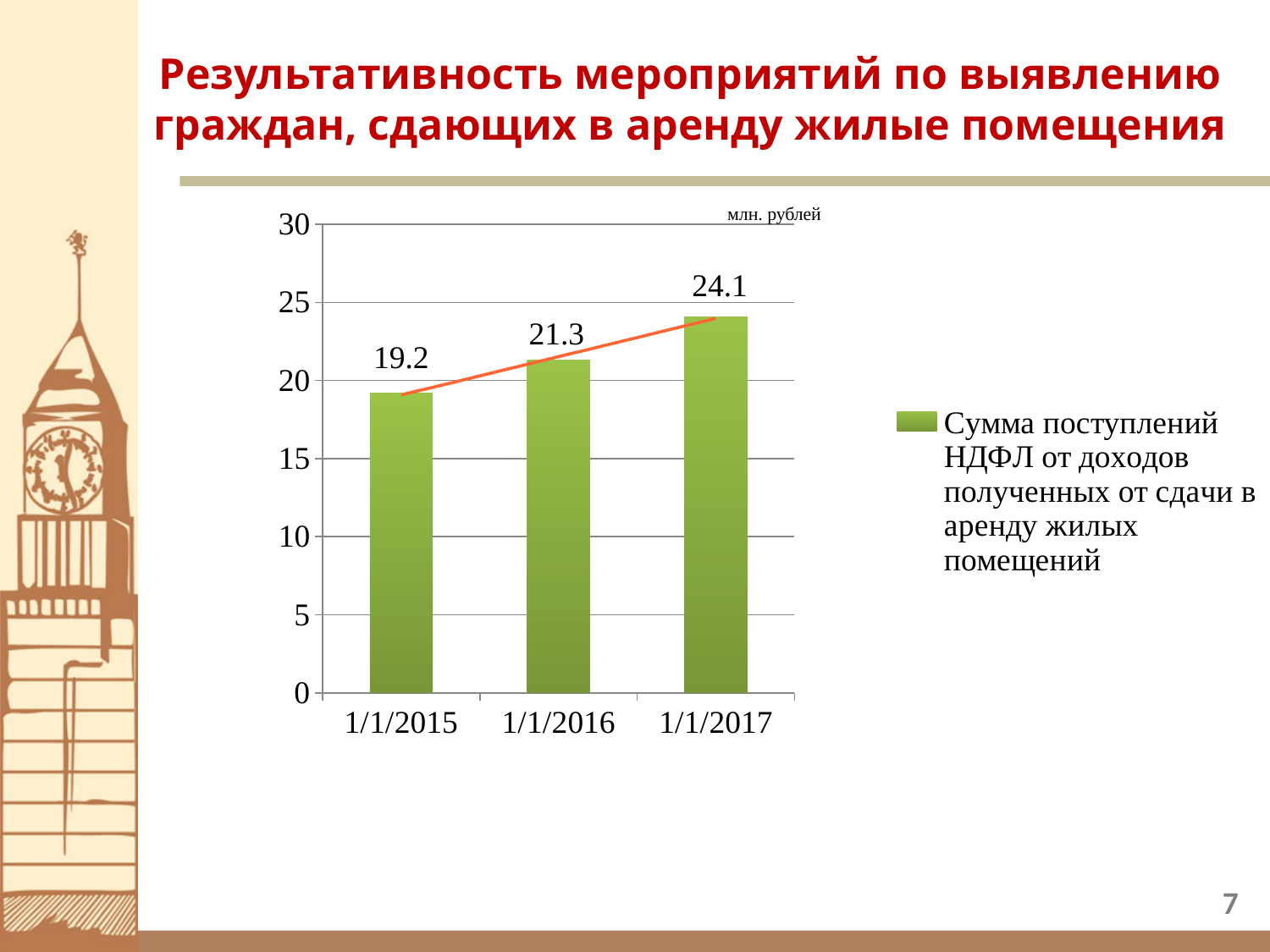
What is the value for 1/1/2017? 24.1 Which is larger, the value for 1/1/2016 or the value for 1/1/2017? 1/1/2017 What is the difference between the values for 1/1/2017 and 1/1/2015? 4.9 What is the value for 1/1/2015? 19.2 What kind of chart is shown on the slide? bar chart Which date has the lowest value? 1/1/2015 What is the difference between the values for 1/1/2016 and 1/1/2015? 2.1 What is the value for 1/1/2016? 21.3 Do the values rise or fall from 1/1/2015 to 1/1/2017? rise Is the value for 1/1/2015 greater or less than 20? less How many dates are shown on the x axis? 3 Which date has the highest value? 1/1/2017